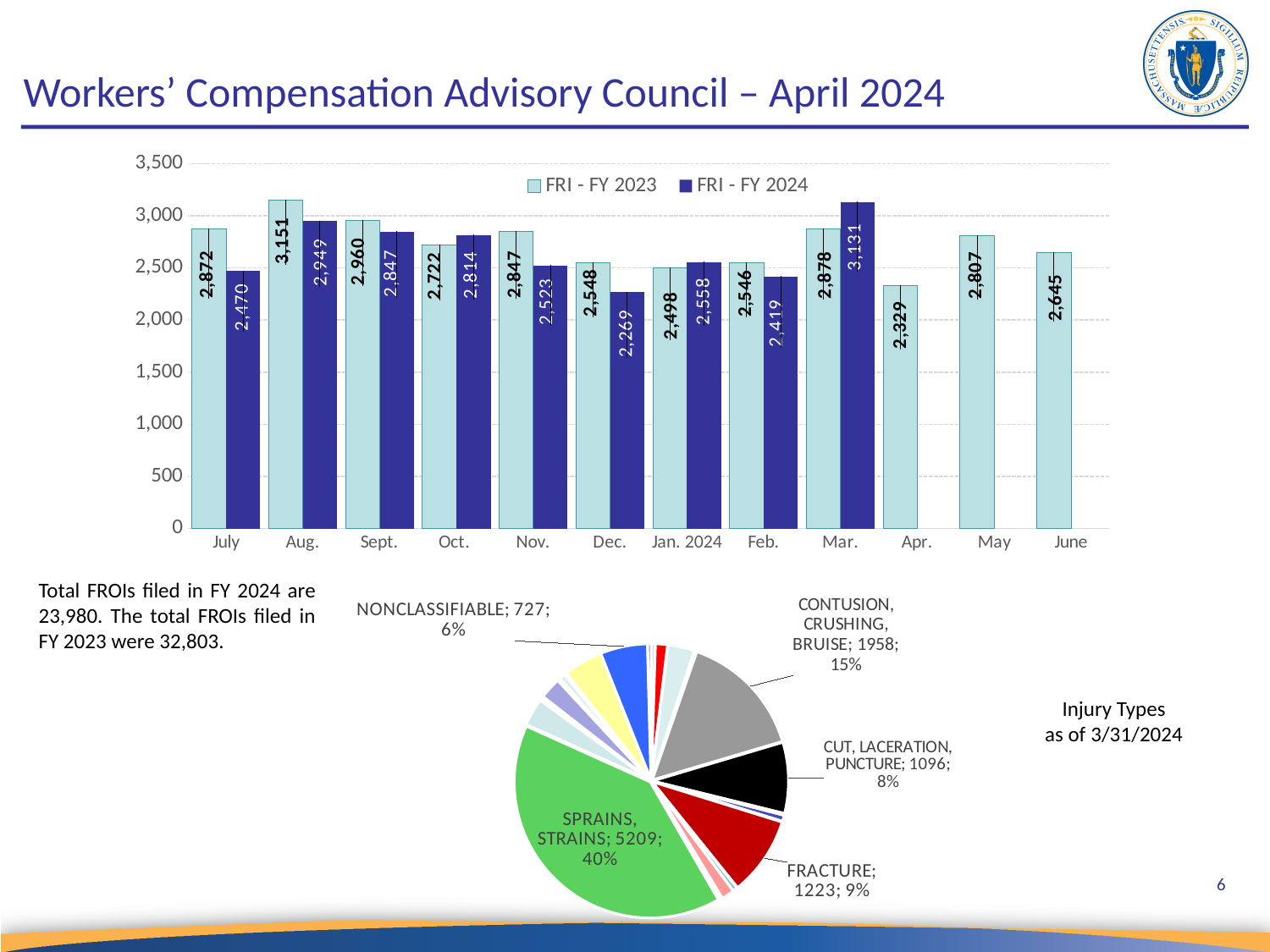
In the bar chart, what is the difference between the FRI - FY 2023 and FRI - FY 2024 values for July? 402 In the pie chart of injury types, which is larger, CONTUSION, CRUSHING, BRUISE or CUT, LACERATION, PUNCTURE? CONTUSION, CRUSHING, BRUISE What kind of chart is the upper chart on the slide? Bar chart In the bar chart, which month has the highest FRI - FY 2024 value? Mar. In the pie chart of injury types, what share do SPRAINS, STRAINS make up? 40% In the bar chart, how many series does the legend list? 2 In the bar chart, how many months are shown on the x axis? 12 In the bar chart, what is the FRI - FY 2024 value for Mar.? 3,131 In the bar chart, which month has the lowest FRI - FY 2023 value? Apr. In the bar chart, what is the FRI - FY 2023 value for Aug.? 3,151 In the bar chart, which is larger for Oct., FRI - FY 2023 or FRI - FY 2024? FRI - FY 2024 In the pie chart of injury types, what is the value for FRACTURE? 1223